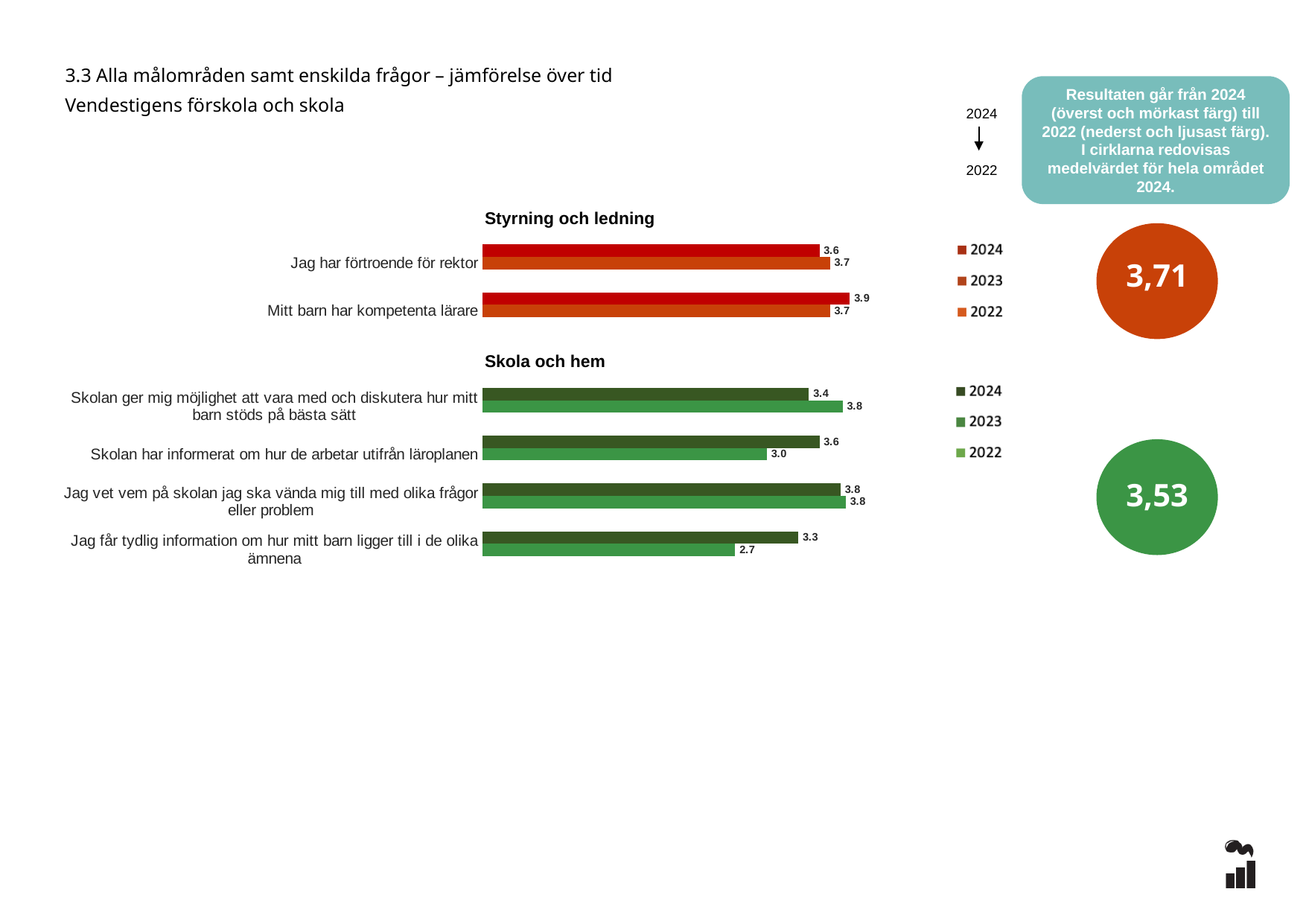
In the 'Skola och hem' chart, what is the 2024 value (top, darkest bar) for 'Jag får tydlig information om hur mitt barn ligger till i de olika ämnena'? 3.3 In the 'Styrning och ledning' chart, what is the 2024 value (top, darkest bar) for 'Mitt barn har kompetenta lärare'? 3.9 In the 'Skola och hem' chart, what is the difference between the two bars for 'Jag får tydlig information om hur mitt barn ligger till i de olika ämnena'? 0.6 How many years does the legend of the 'Styrning och ledning' chart list? 3 In the 'Styrning och ledning' chart, what is the value of the lighter (lower) bar for 'Jag har förtroende för rektor'? 3.7 In the 'Skola och hem' chart, which question has the highest 2024 value (top, darkest bar)? Jag vet vem på skolan jag ska vända mig till med olika frågor eller problem In the 'Skola och hem' chart, which question has the lowest 2024 value (top, darkest bar)? Jag får tydlig information om hur mitt barn ligger till i de olika ämnena How many questions (categories) are shown in the 'Skola och hem' chart? 4 In the 'Styrning och ledning' chart, what is the difference between the two bars for 'Mitt barn har kompetenta lärare'? 0.2 In the 'Skola och hem' chart, what is the value of the lighter (lower) bar for 'Skolan har informerat om hur de arbetar utifrån läroplanen'? 3.0 What kind of chart is used for 'Skola och hem'? Bar chart In the 'Styrning och ledning' chart, which has the higher 2024 value: 'Jag har förtroende för rektor' or 'Mitt barn har kompetenta lärare'? Mitt barn har kompetenta lärare